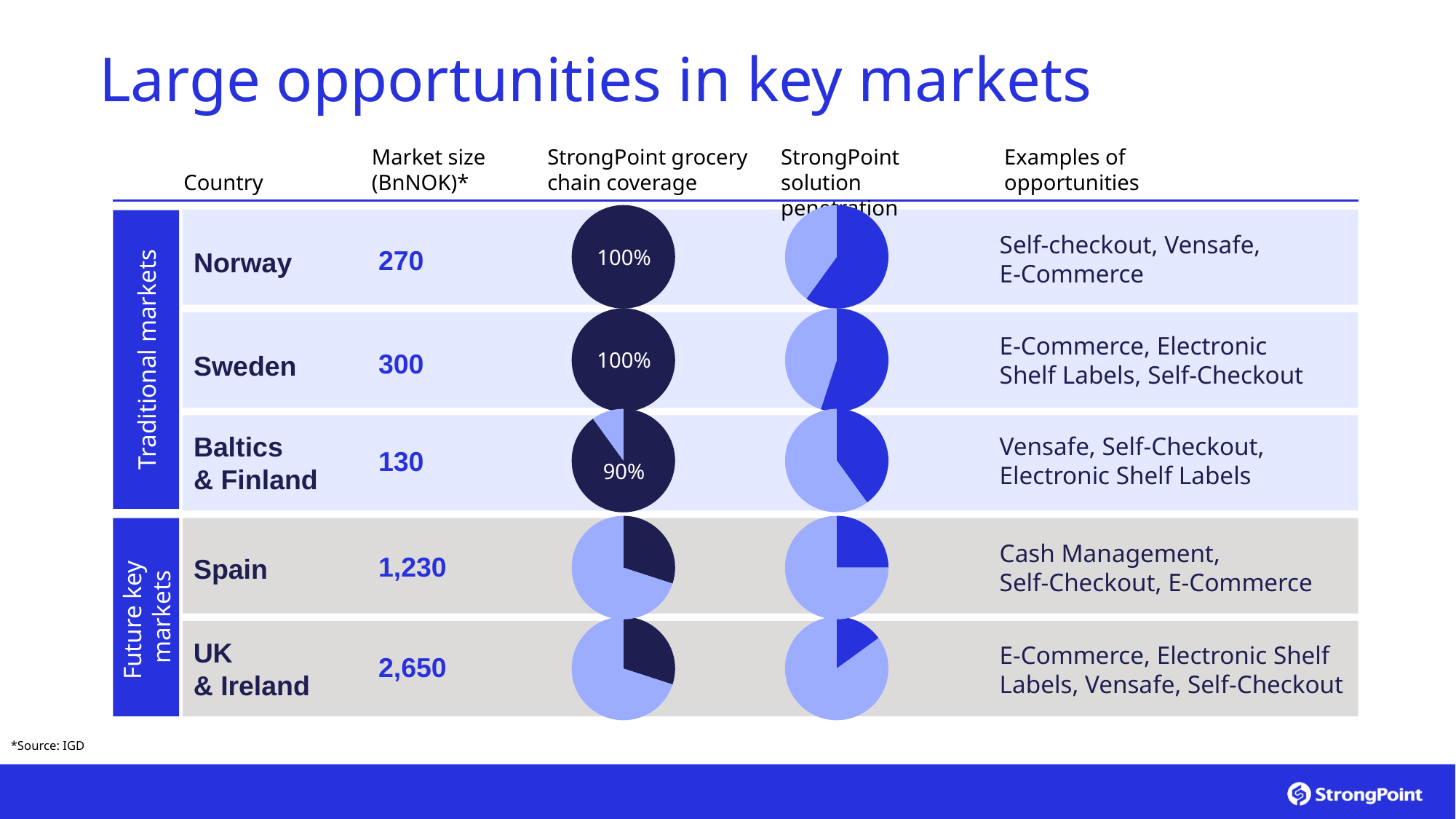
What is the StrongPoint grocery chain coverage shown for Baltics & Finland? 90% What is the StrongPoint grocery chain coverage shown for Norway? 100% Which has the larger StrongPoint grocery chain coverage, Norway or Spain? Norway What is the market size (BnNOK) shown for UK & Ireland? 2,650 Among the traditional markets, which country row has the lowest StrongPoint grocery chain coverage? Baltics & Finland What is the StrongPoint grocery chain coverage shown for Sweden? 100% What kind of charts are used in the StrongPoint grocery chain coverage column? Pie charts How many pie charts are shown in the StrongPoint grocery chain coverage column? 5 Which country row has the largest market size (BnNOK)? UK & Ireland Which has the larger StrongPoint solution penetration, Norway or UK & Ireland? Norway What is the difference between the grocery chain coverage for Norway and for Baltics & Finland? 10% How many country rows are shown in the table? 5